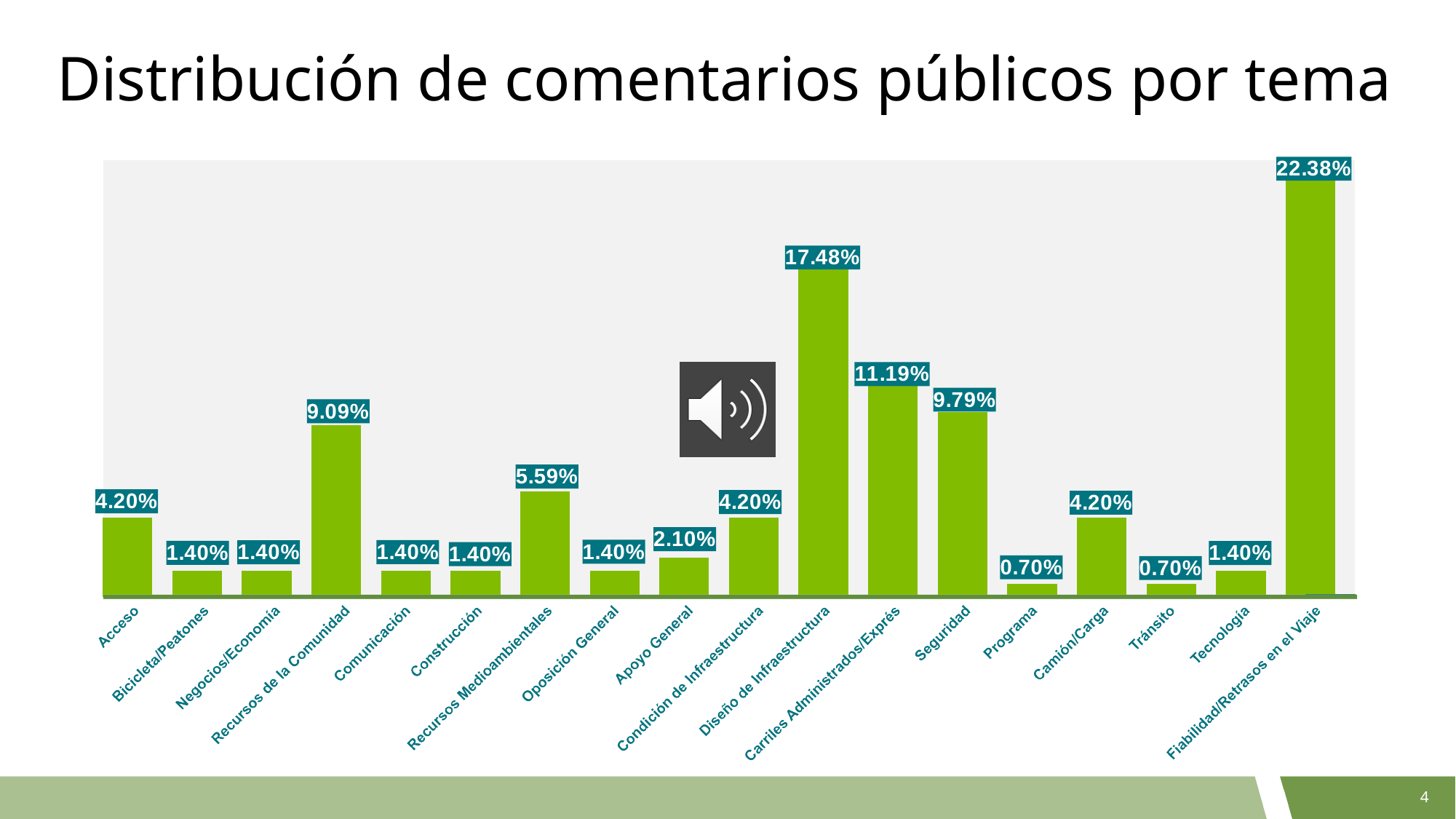
What is the difference between Fiabilidad/Retrasos en el Viaje and Diseño de Infraestructura? 4.90% How many categories are shown in the chart? 18 Which category has the highest value? Fiabilidad/Retrasos en el Viaje Which is larger, Recursos de la Comunidad or Recursos Medioambientales? Recursos de la Comunidad What is the value for Fiabilidad/Retrasos en el Viaje? 22.38% What is the value for Diseño de Infraestructura? 17.48% What is the difference between Carriles Administrados/Exprés and Seguridad? 1.40% What is the title of the slide? Distribución de comentarios públicos por tema What is the value for Recursos de la Comunidad? 9.09% What is the value for Seguridad? 9.79% What type of chart is shown on the slide? bar chart What is the value for Apoyo General? 2.10%